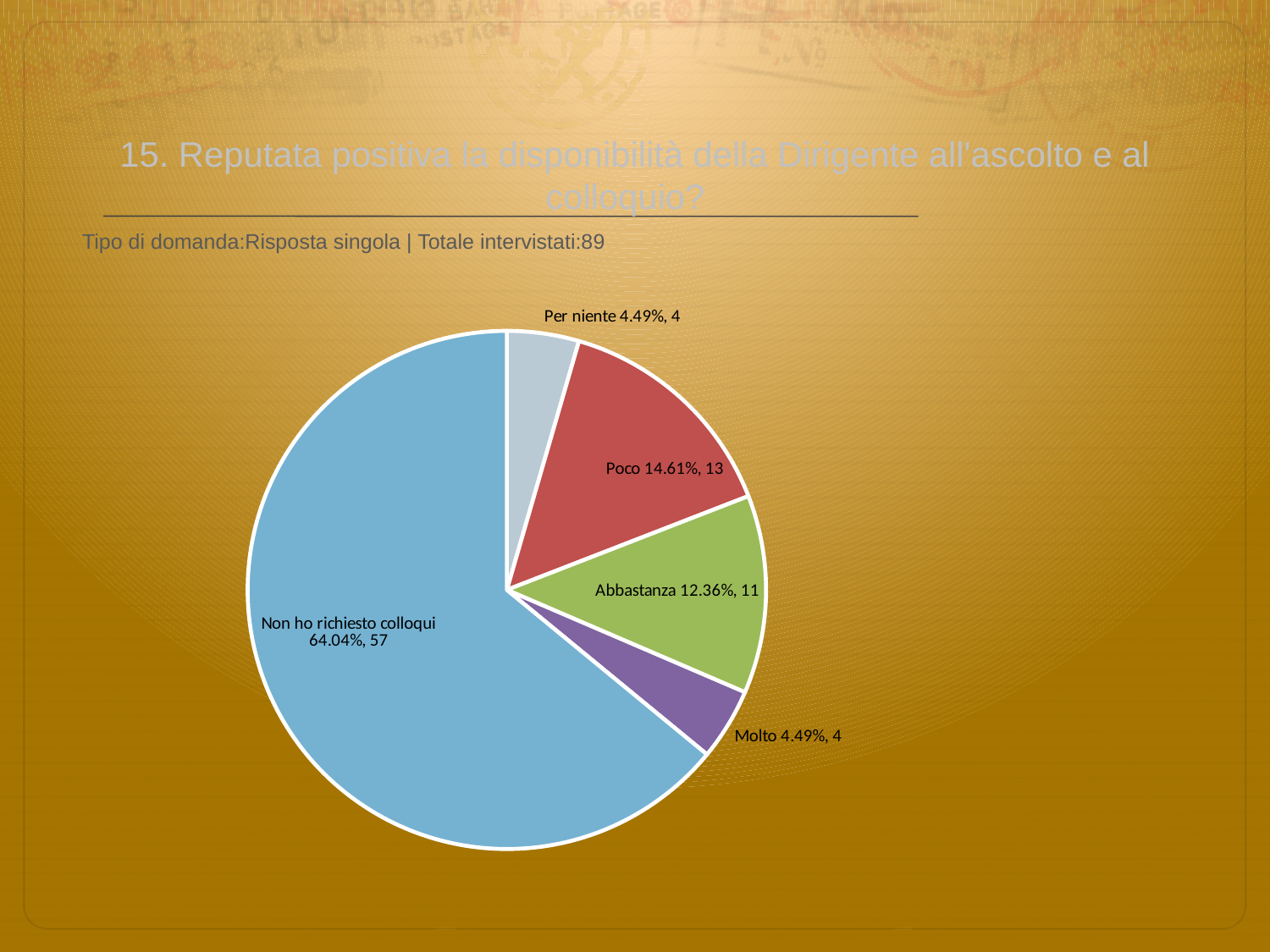
How many respondents answered 'Molto'? 4 What is the total number of interviewees stated on the slide? 89 How many slices does the pie chart have? 5 What percentage is shown for 'Abbastanza'? 12.36% Which category has more respondents, 'Poco' or 'Abbastanza'? Poco What is the difference in respondent count between 'Non ho richiesto colloqui' and 'Poco'? 44 What kind of chart is shown on the slide? pie chart Which category has the largest slice of the pie? Non ho richiesto colloqui What percentage is shown for 'Per niente'? 4.49% What percentage share does the 'Non ho richiesto colloqui' slice have? 64.04% How many respondents answered 'Poco'? 13 What is the difference in respondent count between 'Poco' and 'Abbastanza'? 2